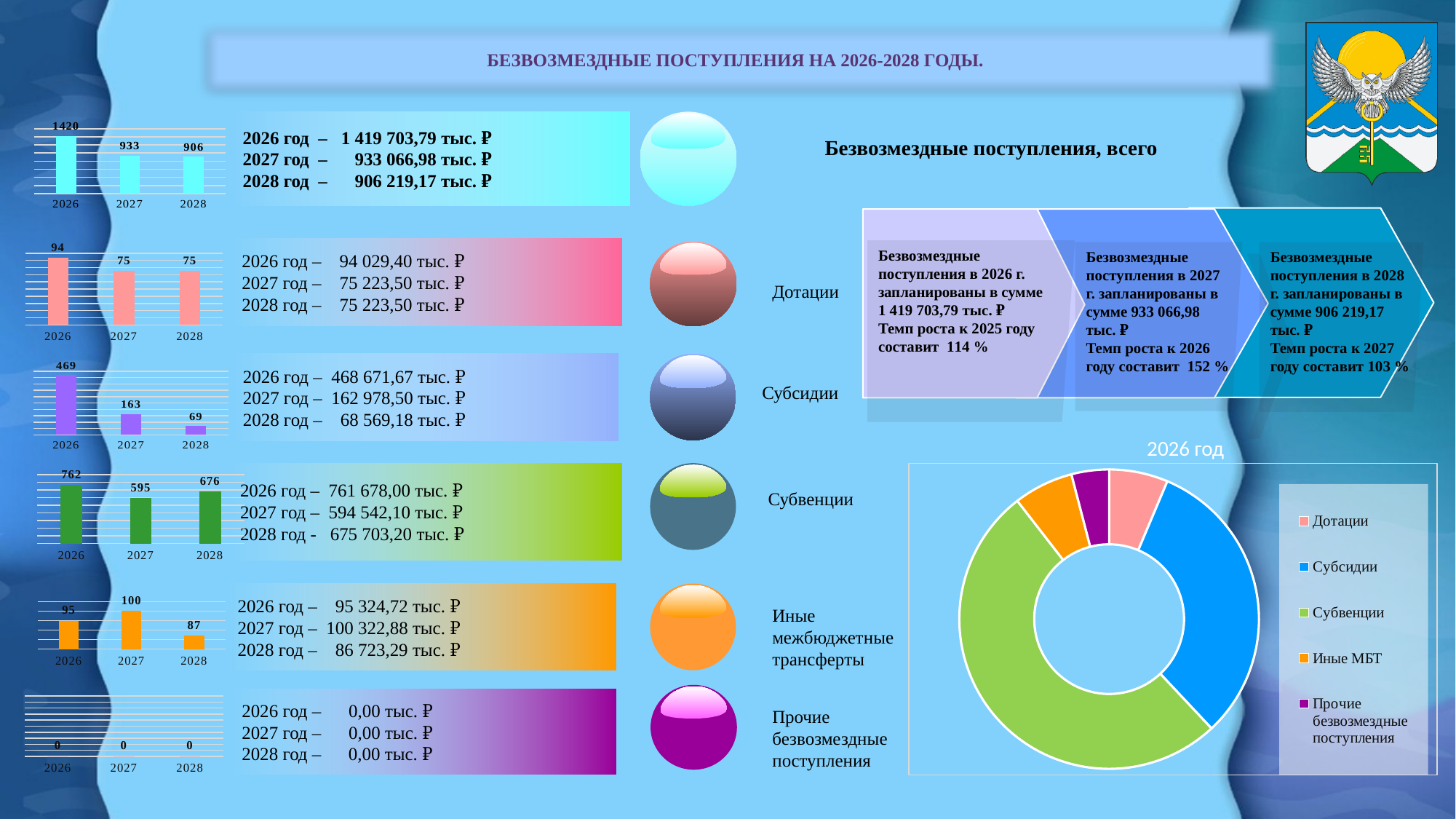
In the top-left bar chart with cyan bars, what is the value for 2026? 1420 In the bottom-left bar chart with the magenta gradient, what is the value for 2028? 0 In the pink bar chart (Дотации) on the left, what is the value for 2027? 75 In the green bar chart (Субвенции) on the left, what is the value for 2026? 762 In the donut chart titled '2026 год', which category has the largest slice? Субвенции In the top-left bar chart with cyan bars, which year has the lowest value? 2028 In the top-left bar chart with cyan bars, what is the difference between the 2026 and 2027 values? 487 How many entries does the legend of the donut chart titled '2026 год' list? 5 In the purple bar chart (Субсидии) on the left, which year has the highest value? 2026 In the purple bar chart (Субсидии) on the left, what is the difference between the 2027 and 2028 values? 94 In the orange bar chart on the left, which year has the highest value? 2027 In the green bar chart (Субвенции) on the left, which is larger: the value for 2027 or the value for 2028? 2028